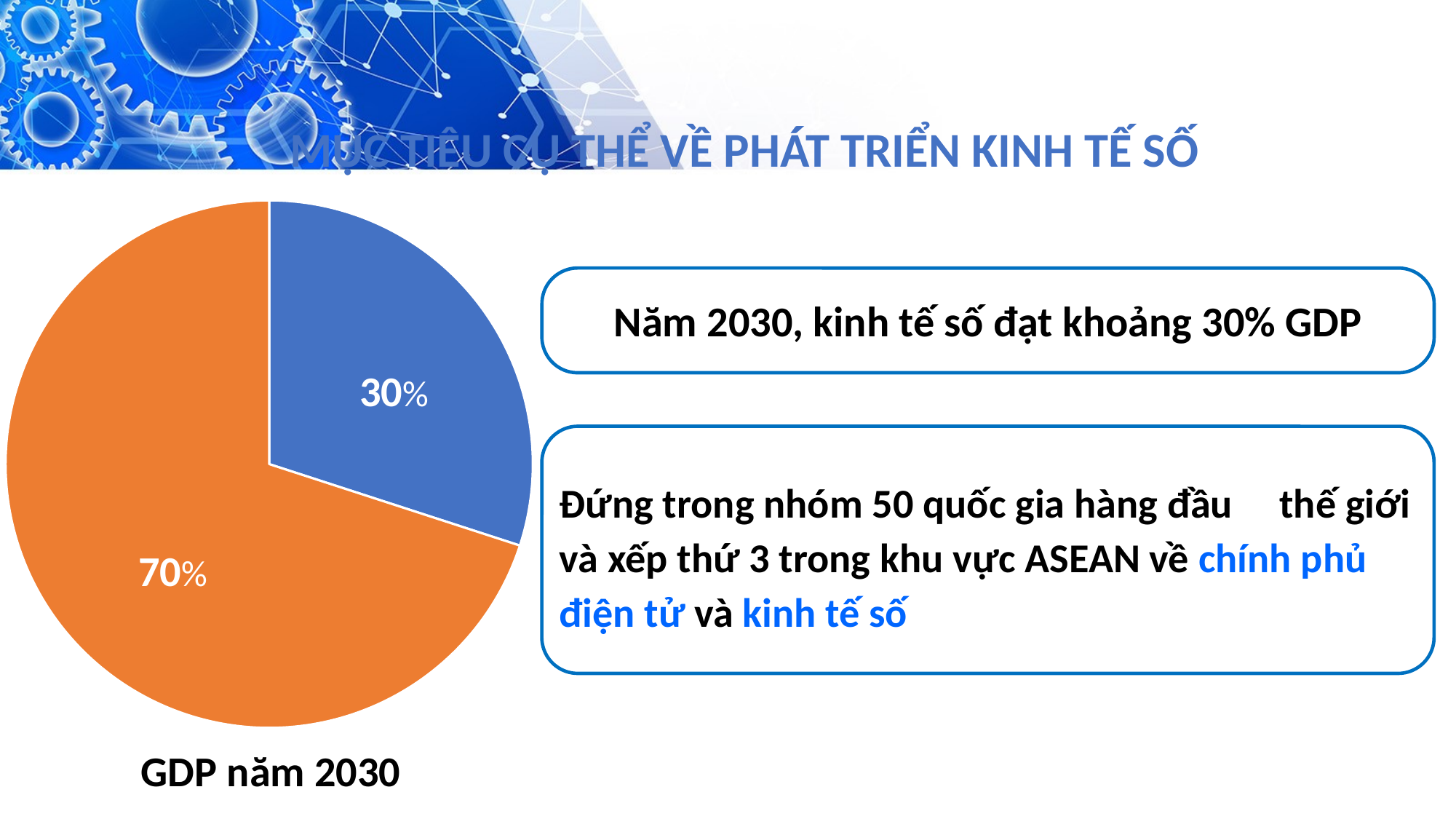
How many slices does the pie chart have? 2 What value is shown on the blue slice of the pie chart? 30% What is the difference between the orange slice and the blue slice in the pie chart? 40% What share of the pie does the blue slice represent? 30% Which is larger in the pie chart, the blue slice or the orange slice? the orange slice What colour is the slice labelled 70% in the pie chart? orange Which slice of the pie chart is the largest? the orange slice (70%) What is the title of the pie chart? GDP năm 2030 Which slice of the pie chart is the smallest? the blue slice (30%) What kind of chart is shown on the slide? pie chart What value is shown on the orange slice of the pie chart? 70%